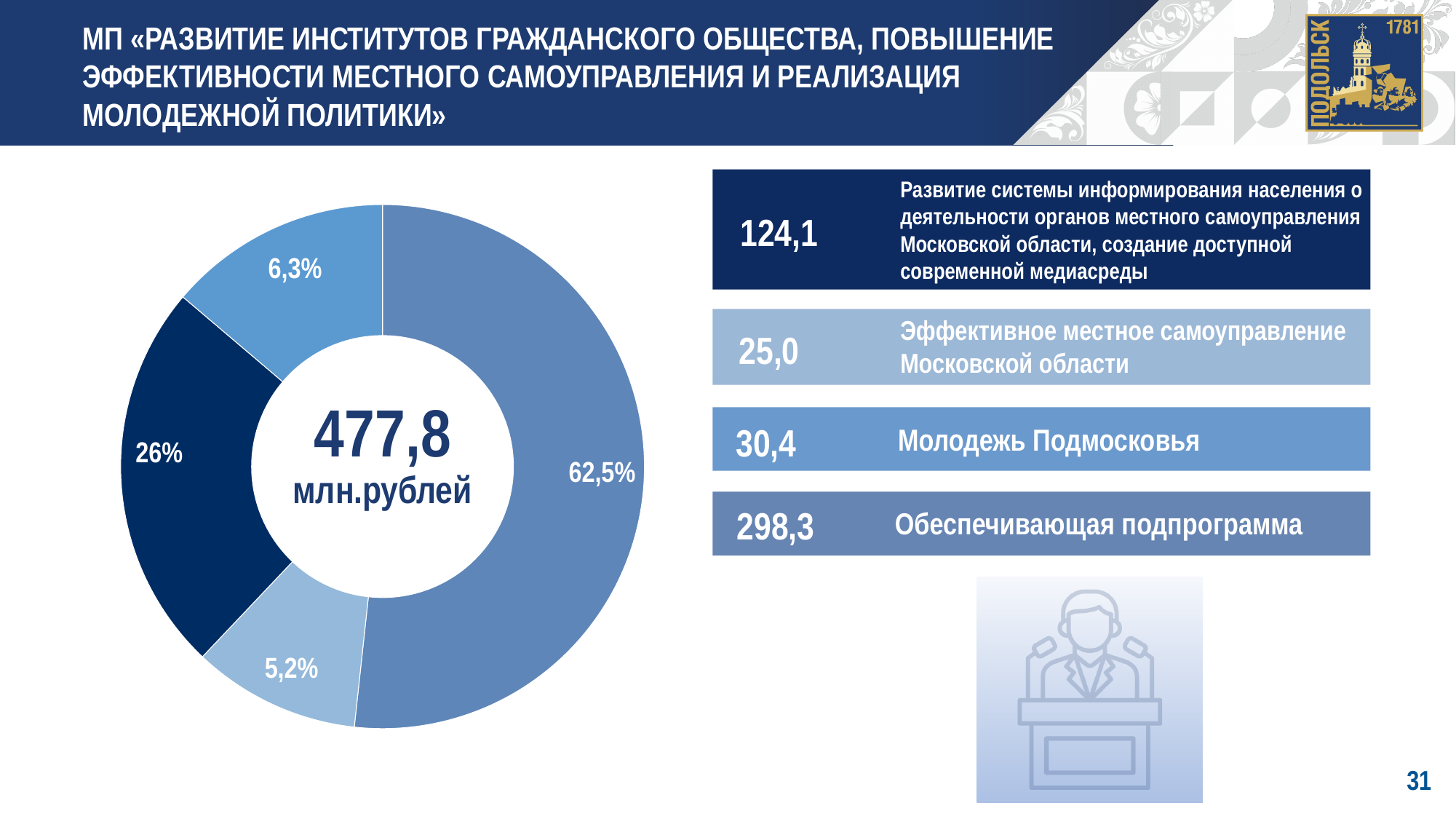
What value is listed for «Эффективное местное самоуправление Московской области»? 25,0 Which is larger: the value for «Молодежь Подмосковья» or for «Эффективное местное самоуправление Московской области»? Молодежь Подмосковья What is the smallest percentage shown on the donut chart? 5,2% What is the difference between the values for «Обеспечивающая подпрограмма» (298,3) and «Развитие системы информирования населения...» (124,1)? 174,2 What percentage is shown for the dark navy slice of the donut chart? 26% How many items are listed in the legend to the right of the donut chart? 4 What value is listed for «Обеспечивающая подпрограмма» in the legend? 298,3 What is the largest percentage shown on the donut chart? 62,5% How many slices does the donut chart have? 4 What kind of chart is shown on the slide? pie chart (donut) What value is listed for «Молодежь Подмосковья» in the legend? 30,4 What total value is printed in the centre of the donut chart? 477,8 млн.рублей